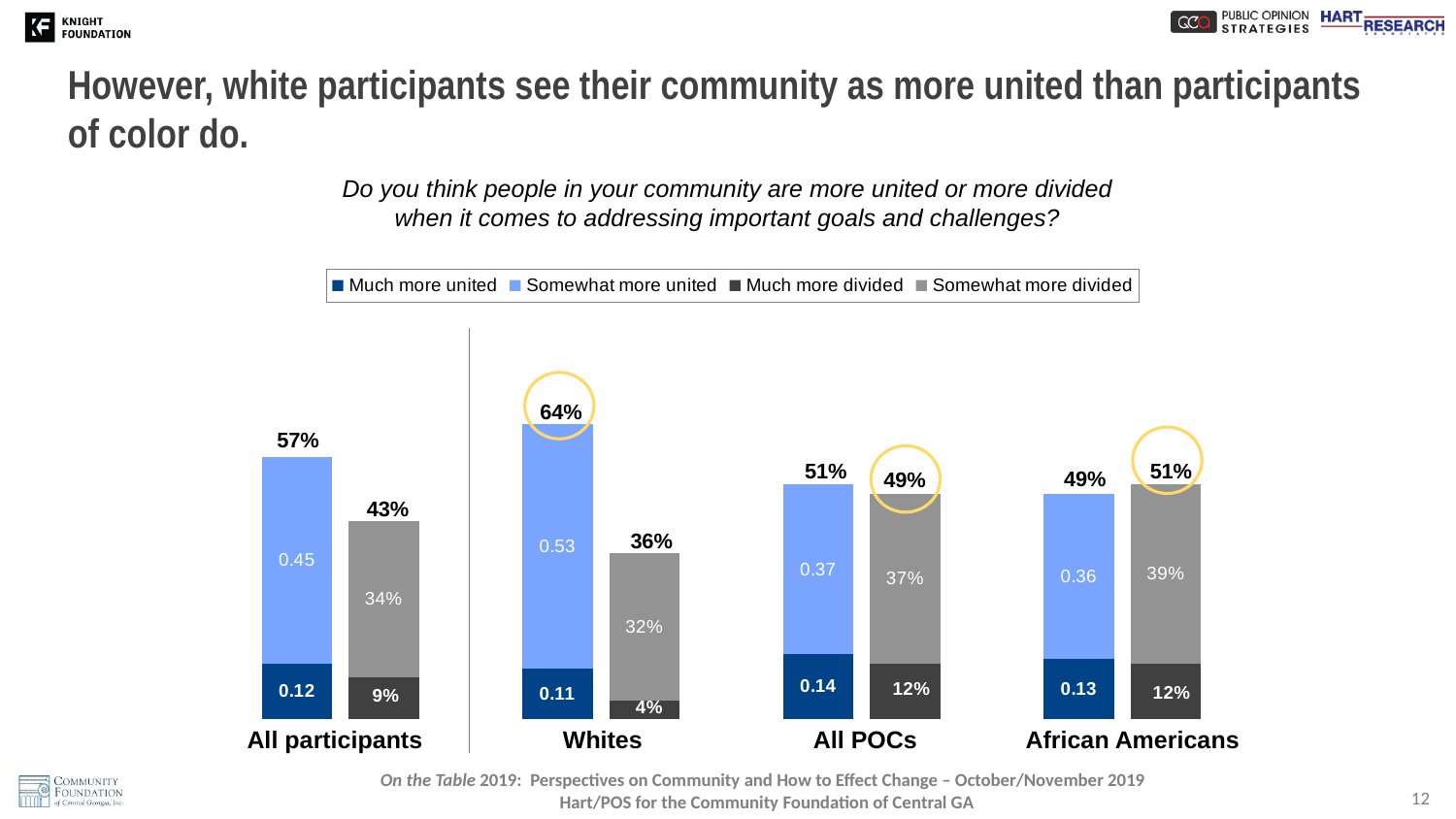
What is the 'Much more united' value labeled for All participants? 0.12 What is the 'Somewhat more divided' value for All POCs? 37% How many participant groups are shown along the x axis? 4 Which group has the highest total 'united' percentage? Whites Which group has the lowest total 'divided' percentage? Whites What is the 'Much more divided' value for Whites? 4% What is the total 'united' percentage shown for Whites? 64% What type of chart is shown on the slide? Stacked bar chart How many series does the legend list? 4 Which is larger for African Americans: the total 'united' percentage or the total 'divided' percentage? Divided (51%) What is the total 'divided' percentage shown for African Americans? 51% What is the difference between the total 'united' percentage for Whites and for All POCs? 13%